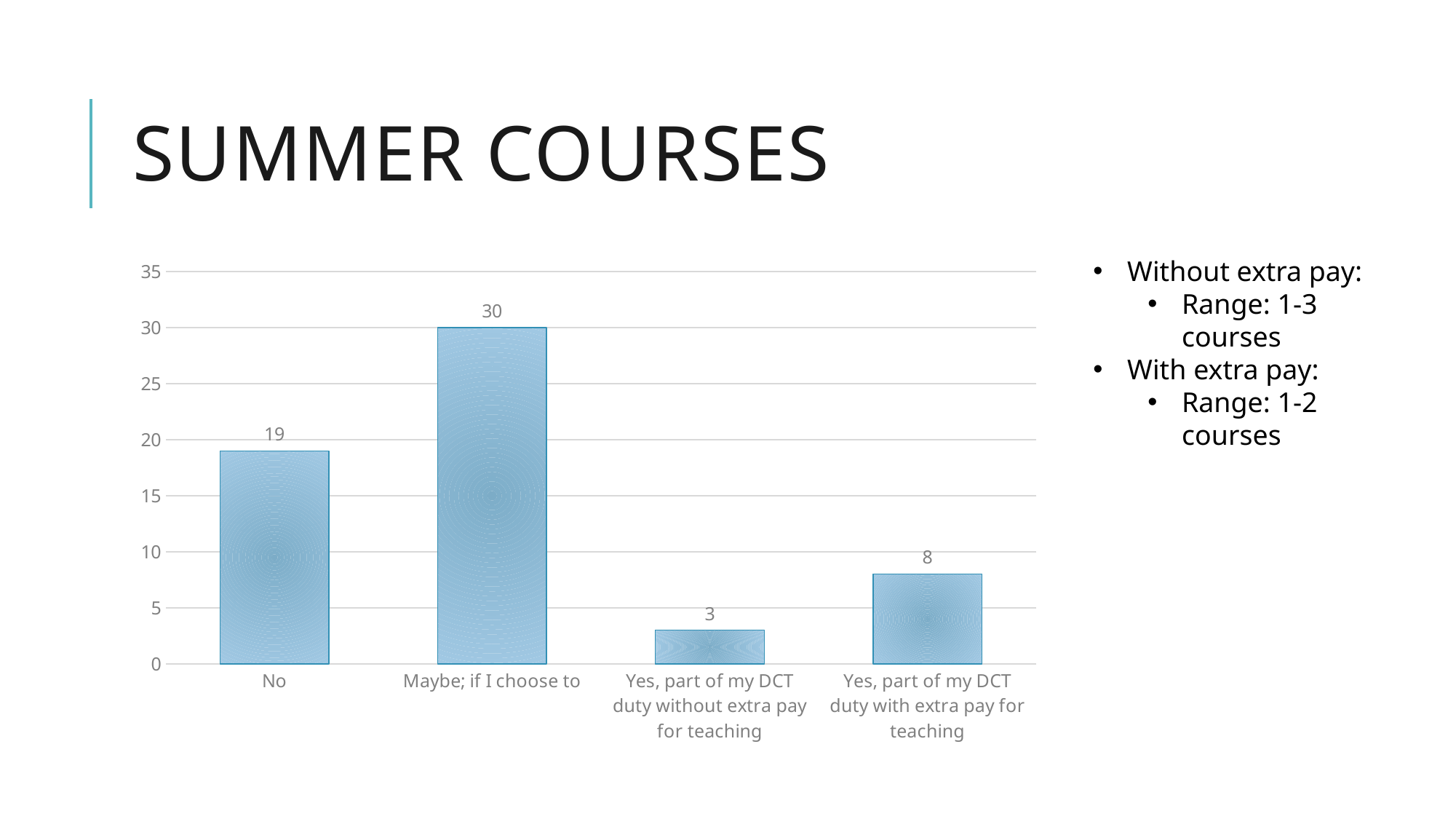
What is the difference between the values for "Maybe; if I choose to" and "No"? 11 How many categories are shown on the x axis of the chart? 4 What kind of chart is shown on the slide? Bar chart What is the difference between the values for "Yes, part of my DCT duty with extra pay for teaching" and "Yes, part of my DCT duty without extra pay for teaching"? 5 What is the value for "Yes, part of my DCT duty without extra pay for teaching"? 3 Which category has the lowest value? Yes, part of my DCT duty without extra pay for teaching Which category has the highest value? Maybe; if I choose to What is the value for "Maybe; if I choose to"? 30 What is the highest value shown on the vertical axis of the chart? 35 What is the value for the "No" category? 19 What is the value for "Yes, part of my DCT duty with extra pay for teaching"? 8 Which is larger: the value for "No" or the value for "Yes, part of my DCT duty with extra pay for teaching"? No